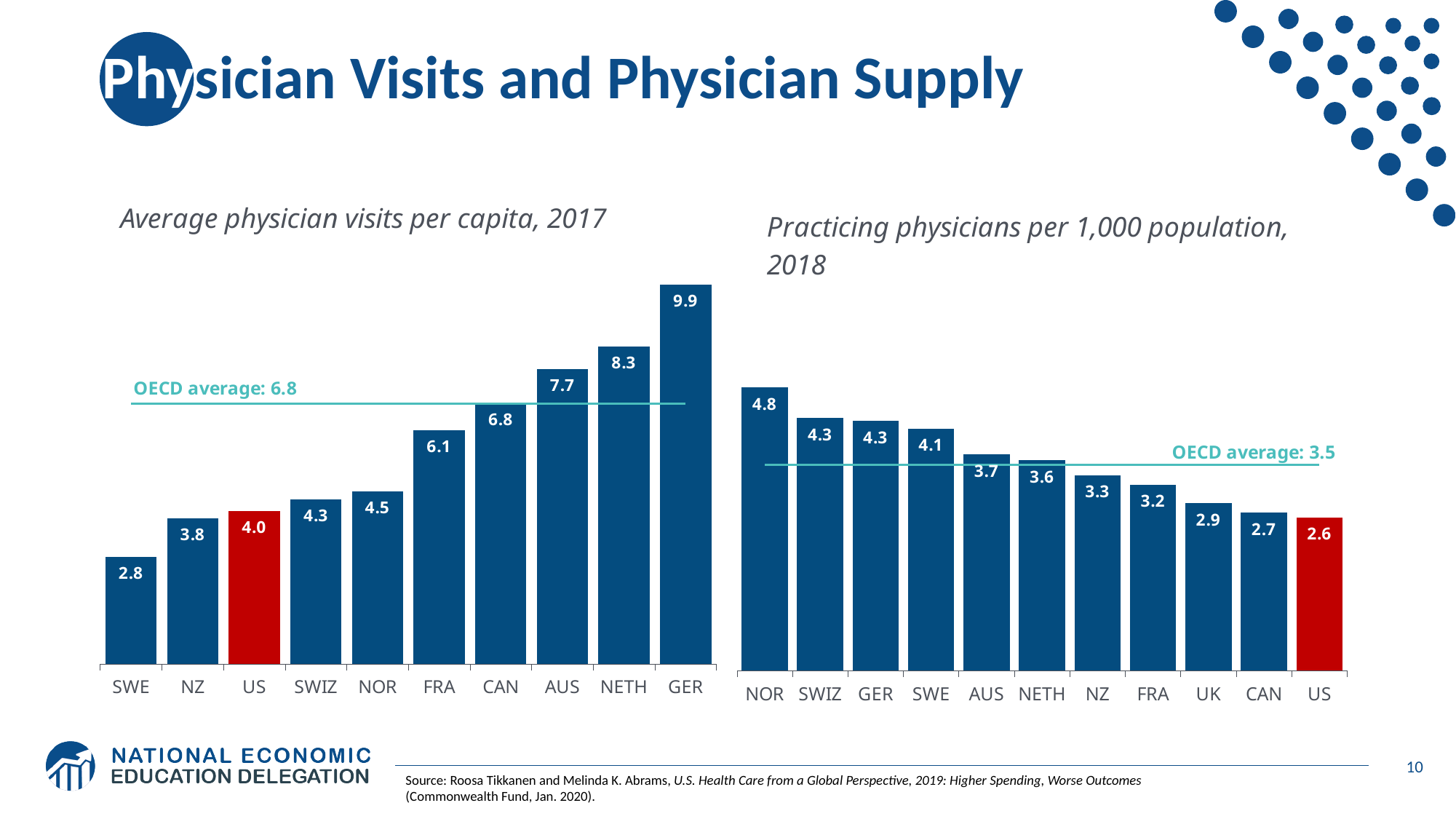
What kind of chart is the 'Average physician visits per capita, 2017' chart? Bar chart In the 'Practicing physicians per 1,000 population, 2018' chart, what is the difference between NOR and US? 2.2 How many countries are shown in the 'Average physician visits per capita, 2017' chart? 10 In the 'Practicing physicians per 1,000 population, 2018' chart, what is the value for NOR? 4.8 How many countries are shown in the 'Practicing physicians per 1,000 population, 2018' chart? 11 What OECD average is marked on the 'Practicing physicians per 1,000 population, 2018' chart? 3.5 In the 'Average physician visits per capita, 2017' chart, which is larger, the value for AUS or the value for FRA? AUS In the 'Average physician visits per capita, 2017' chart, what is the value for US? 4.0 In the 'Average physician visits per capita, 2017' chart, what is the difference between GER and SWE? 7.1 In the 'Average physician visits per capita, 2017' chart, which country has the lowest value? SWE In the 'Practicing physicians per 1,000 population, 2018' chart, which country has the lowest value? US In the 'Average physician visits per capita, 2017' chart, what is the value for GER? 9.9